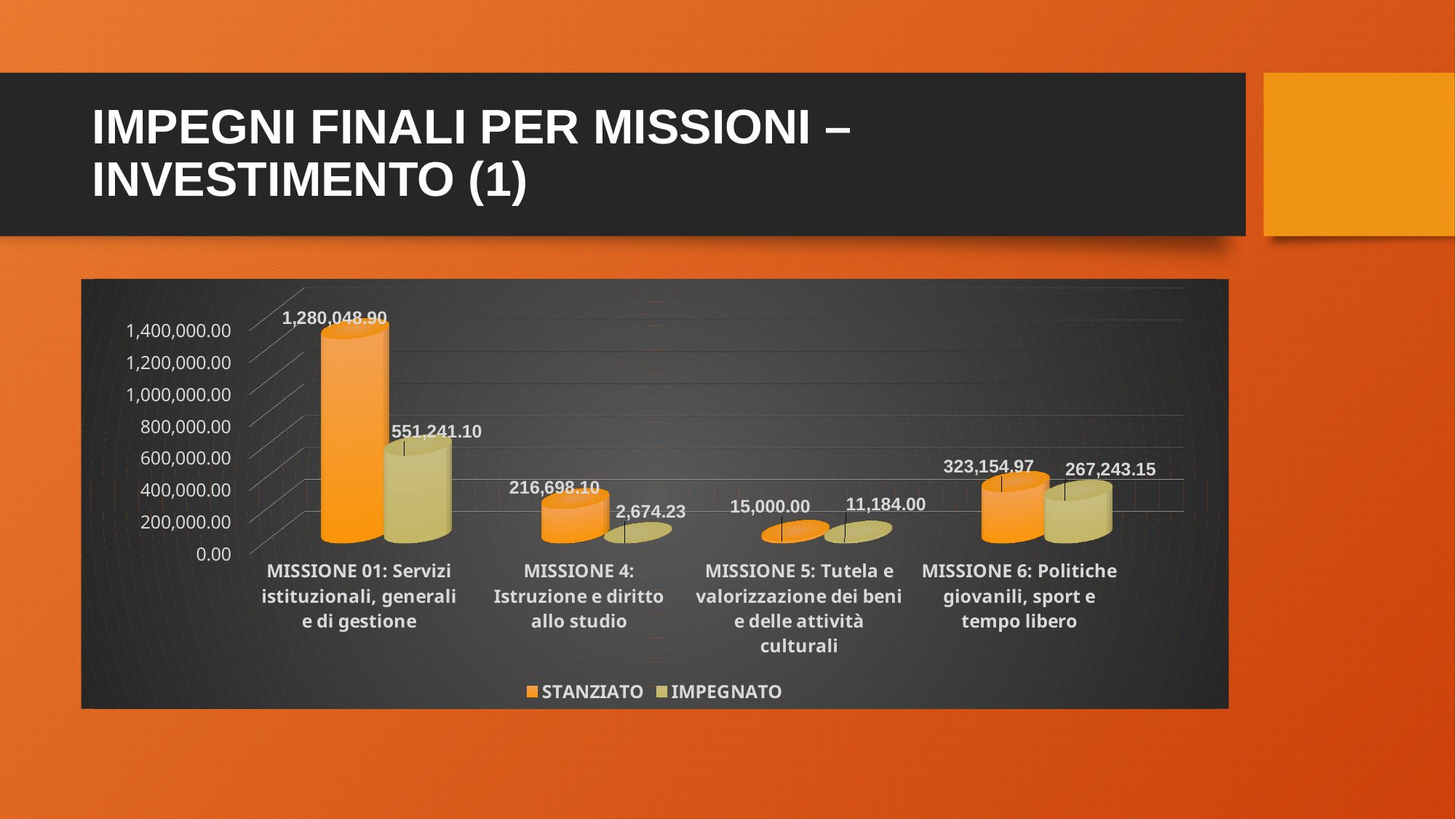
How many missions (categories) are shown on the x axis? 4 What is the difference between STANZIATO and IMPEGNATO for MISSIONE 01: Servizi istituzionali, generali e di gestione? 728,807.80 How many series does the legend list? 2 Which is larger: the IMPEGNATO value for MISSIONE 01 or the STANZIATO value for MISSIONE 6? IMPEGNATO for MISSIONE 01 What is the difference between STANZIATO and IMPEGNATO for MISSIONE 6: Politiche giovanili, sport e tempo libero? 55,911.82 What kind of chart is shown on the slide? Bar chart Which mission has the highest STANZIATO value? MISSIONE 01: Servizi istituzionali, generali e di gestione What is the STANZIATO value for MISSIONE 01: Servizi istituzionali, generali e di gestione? 1,280,048.90 What is the STANZIATO value for MISSIONE 5: Tutela e valorizzazione dei beni e delle attività culturali? 15,000.00 What is the IMPEGNATO value for MISSIONE 6: Politiche giovanili, sport e tempo libero? 267,243.15 What is the IMPEGNATO value for MISSIONE 4: Istruzione e diritto allo studio? 2,674.23 Which mission has the lowest IMPEGNATO value? MISSIONE 4: Istruzione e diritto allo studio